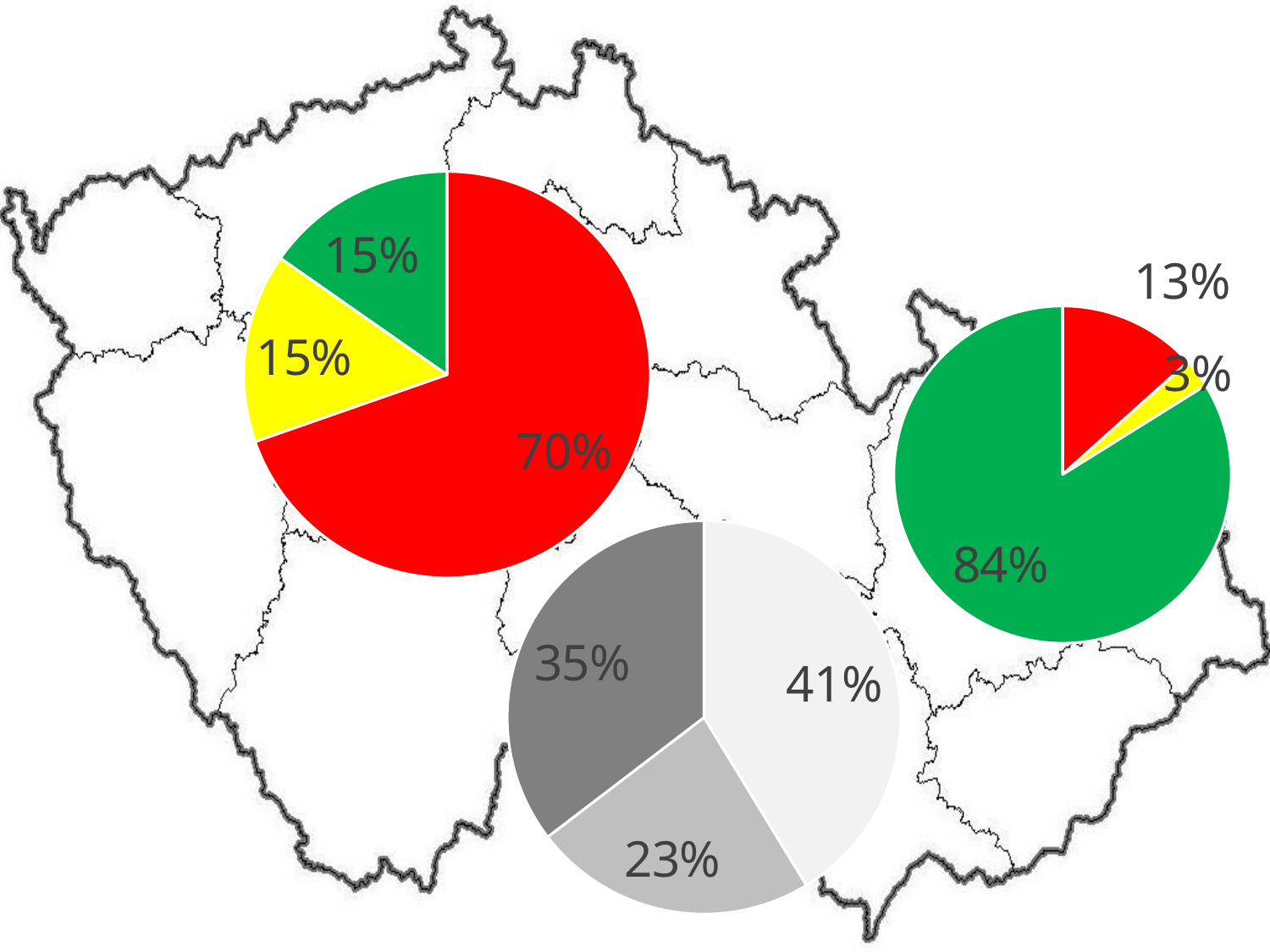
In the pie chart on the right, what is the difference between the green slice and the red slice? 71% How many pie charts are on the slide? 3 In the pie chart on the left, how many slices are there? 3 In the pie chart on the left, what percentage does the yellow slice show? 15% What kind of charts are shown on the slide? Pie charts In the pie chart at the bottom, which is larger, the 35% slice or the 23% slice? The 35% slice In the pie chart on the right, what percentage does the yellow slice show? 3% In the pie chart at the bottom, what percentage does the lightest grey slice show? 41% In the pie chart on the right, what percentage does the green slice show? 84% In the pie chart on the left, what percentage does the red slice show? 70% In the pie chart on the left, which colour slice is the largest? Red In the pie chart on the right, which colour slice is the smallest? Yellow